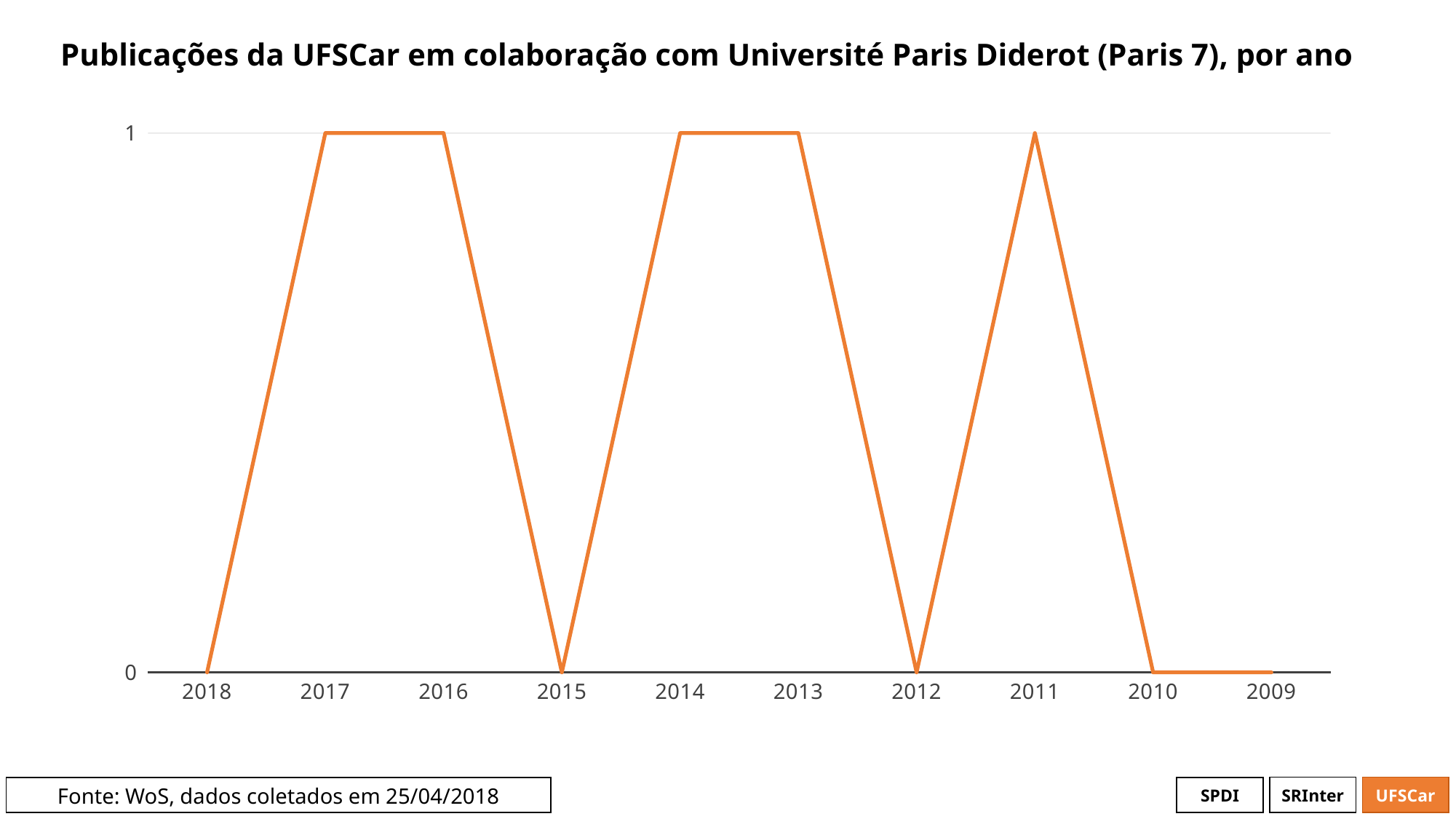
What is the value for 2015? 0 What is the value for 2018? 0 In how many years is the value equal to 1? 5 What is the title of the chart? Publicações da UFSCar em colaboração com Université Paris Diderot (Paris 7), por ano What colour is the line in the chart? orange What is the difference between the value for 2013 and the value for 2010? 1 What is the value for 2011? 1 What is the value for 2009? 0 How many years are shown on the x axis? 10 Which is larger, the value for 2014 or the value for 2012? 2014 What kind of chart is shown on the slide? line chart What is the value for 2017? 1